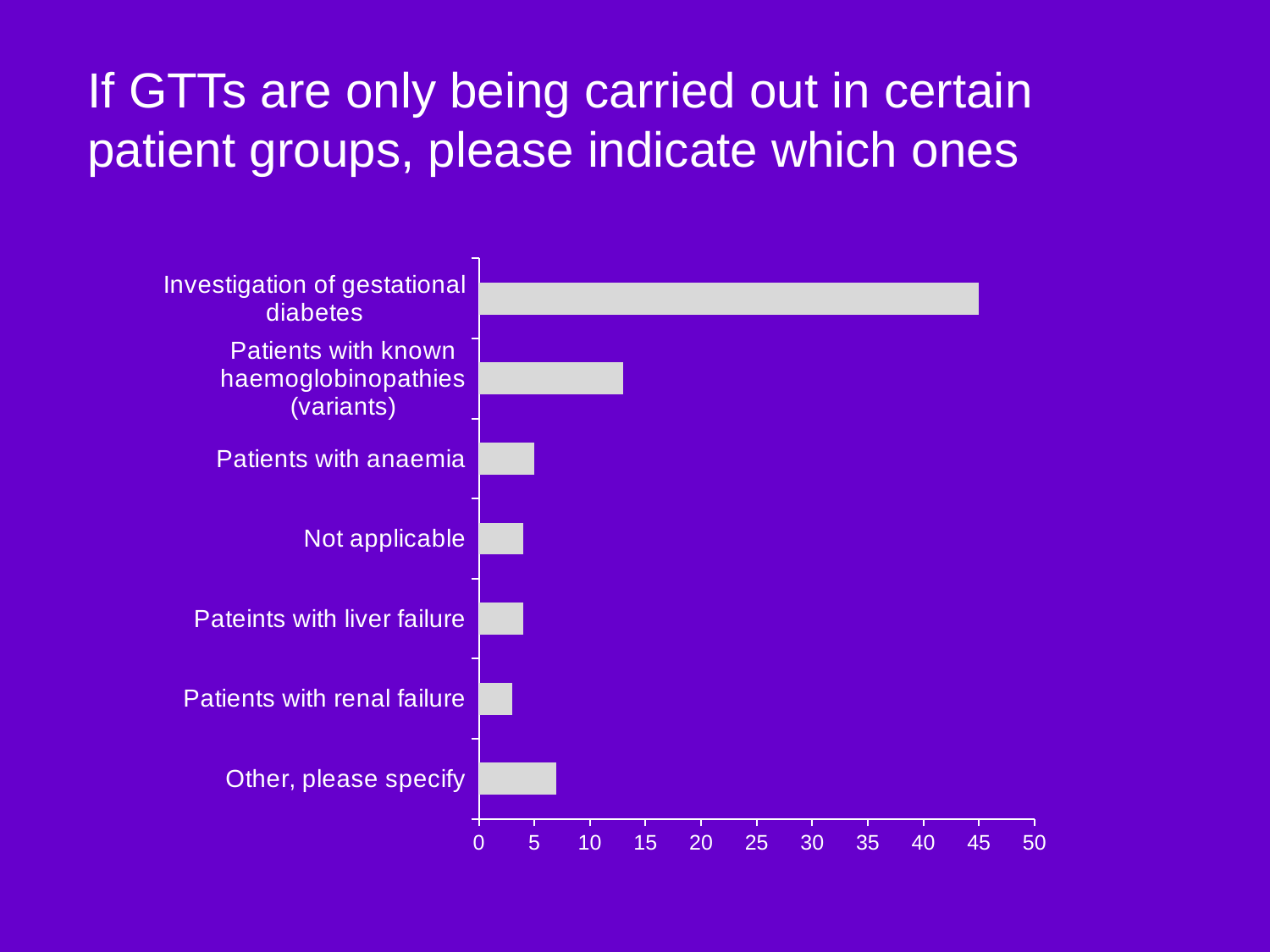
Is the value for Patients with known haemoglobinopathies (variants) greater or less than 15? less What is the value for Investigation of gestational diabetes? 45 Is the value for Patients with known haemoglobinopathies (variants) greater or less than 10? greater Which is larger, the value for Patients with known haemoglobinopathies (variants) or the value for Other, please specify? Patients with known haemoglobinopathies (variants) Is the value for Patients with renal failure greater or less than 5? less What is the maximum value shown on the horizontal axis of the chart? 50 How many patient group categories are shown in the chart? 7 Which category has the highest value in the chart? Investigation of gestational diabetes What kind of chart is shown on the slide? bar chart Which is larger, the value for Other, please specify or the value for Patients with renal failure? Other, please specify